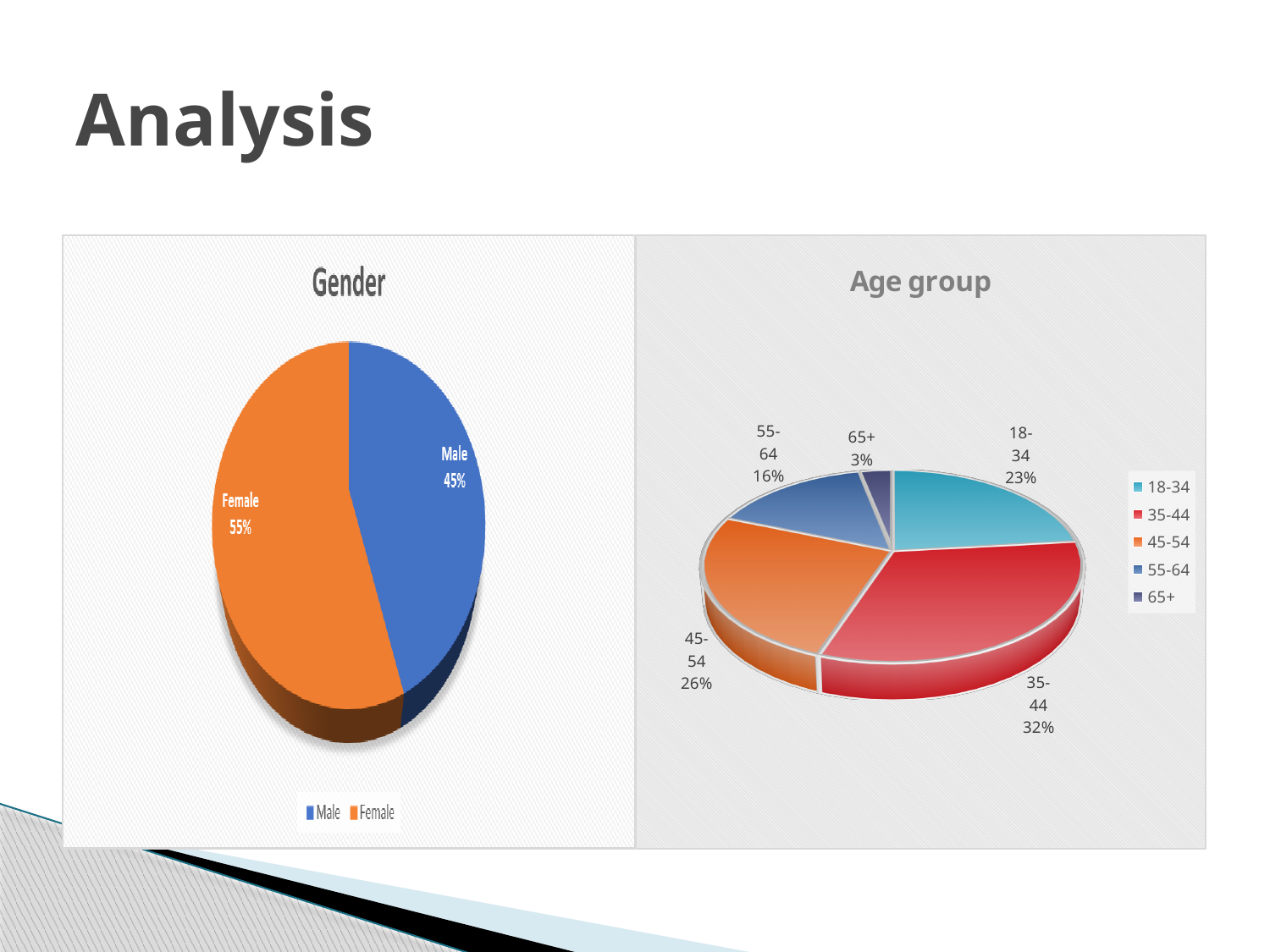
In the Gender chart, what is the difference between the Female and Male shares? 10% In the Gender chart, what percentage is Male? 45% In the Age group chart, how many age groups are shown? 5 In the Age group chart, what percentage is the 55-64 group? 16% In the Age group chart, which age group has the largest share? 35-44 In the Gender chart, which category has the larger share? Female In the Gender chart, what percentage is Female? 55% In the Age group chart, which is larger: the 18-34 share or the 55-64 share? 18-34 In the Age group chart, what is the difference between the 45-54 and 18-34 shares? 3% What kind of chart is the Gender chart? Pie chart In the Age group chart, what percentage is the 35-44 group? 32% In the Age group chart, which age group has the smallest share? 65+